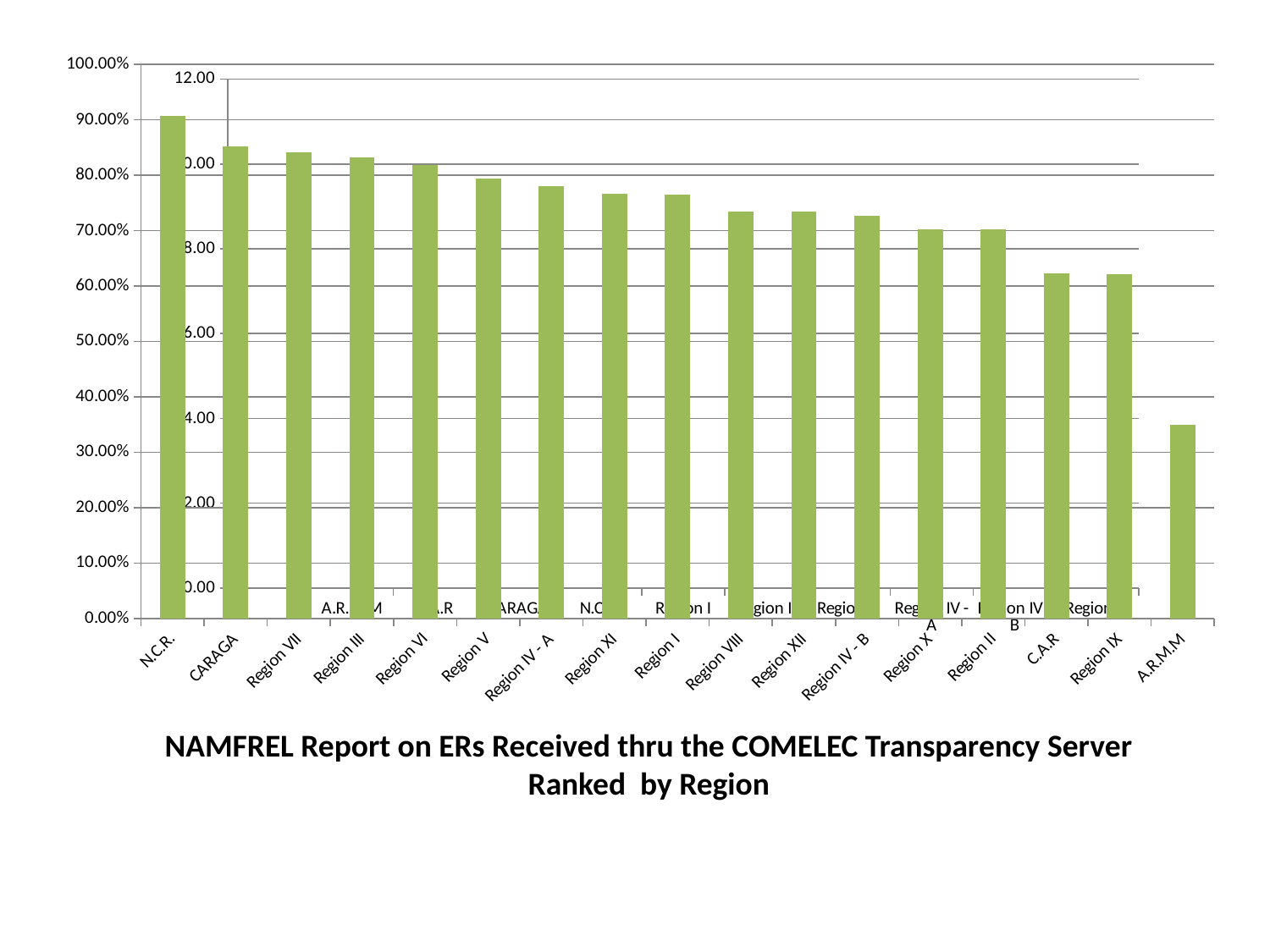
Which region has the lowest value in the chart? A.R.M.M What is the title of the chart? NAMFREL Report on ERs Received thru the COMELEC Transparency Server Ranked by Region Which region has the highest value in the chart? N.C.R. Which has the larger value, CARAGA or Region IX? CARAGA Do the values rise or fall moving from left to right along the x axis? fall How many regions are plotted in the chart? 17 Is the value for Region VIII greater or less than 70.00%? greater Is the value for A.R.M.M greater or less than 40.00%? less What kind of chart is shown on the slide? bar chart Is the value for CARAGA greater or less than 80.00%? greater